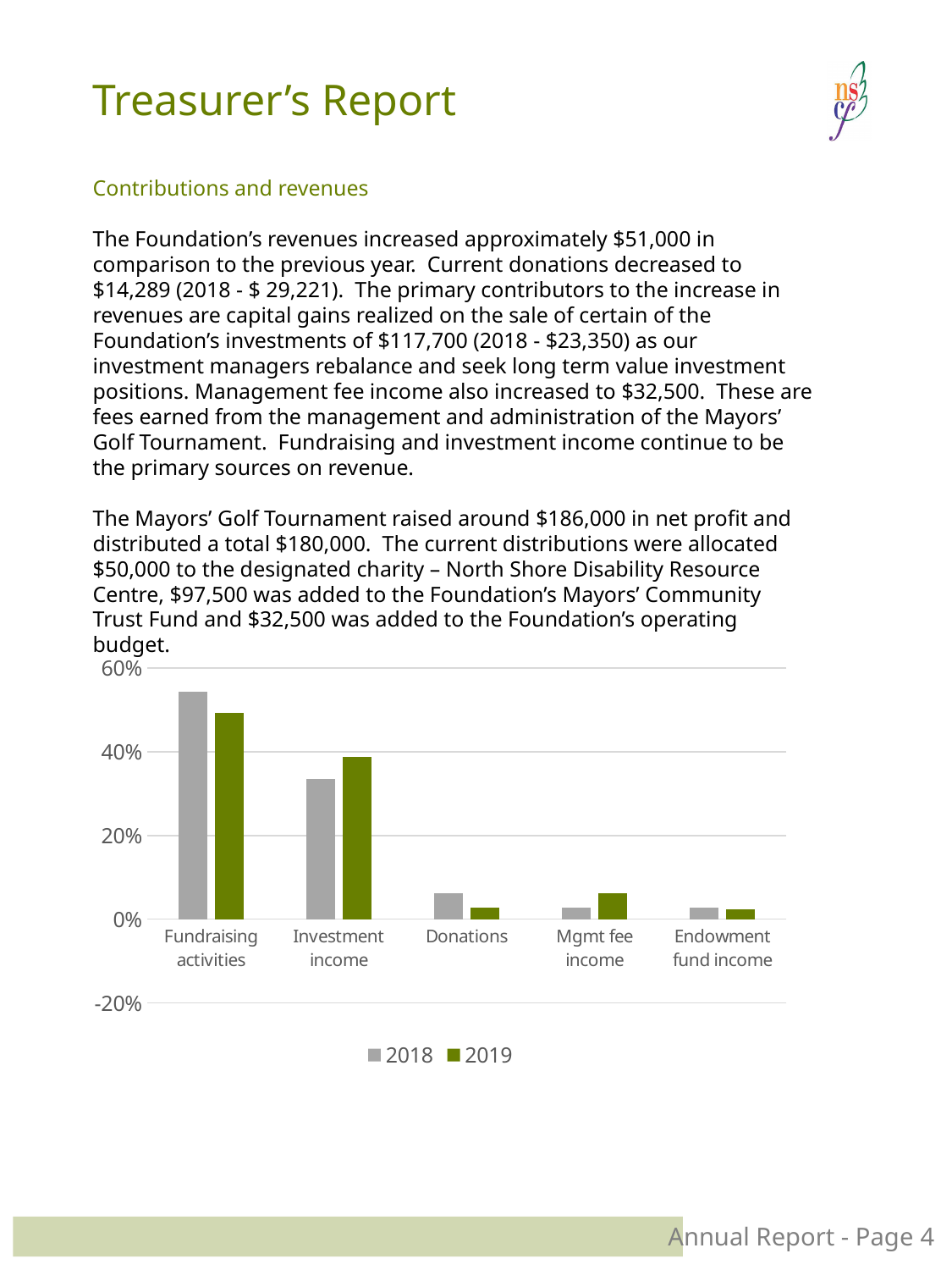
For Investment income, which year has the larger value, 2018 or 2019? 2019 Is the 2019 value for Donations greater or less than 20%? less Which category has the highest value for 2018? Fundraising activities What kind of chart is shown on the slide? bar chart How many categories are shown on the x axis of the chart? 5 For Fundraising activities, which year has the larger value, 2018 or 2019? 2018 Which category has the highest value for 2019? Fundraising activities Which colour represents the 2019 series in the chart? green How many series does the chart's legend list? 2 Is the 2018 value for Fundraising activities greater or less than 40%? greater Is the 2018 value for Investment income greater or less than 40%? less For Mgmt fee income, which year has the larger value, 2018 or 2019? 2019